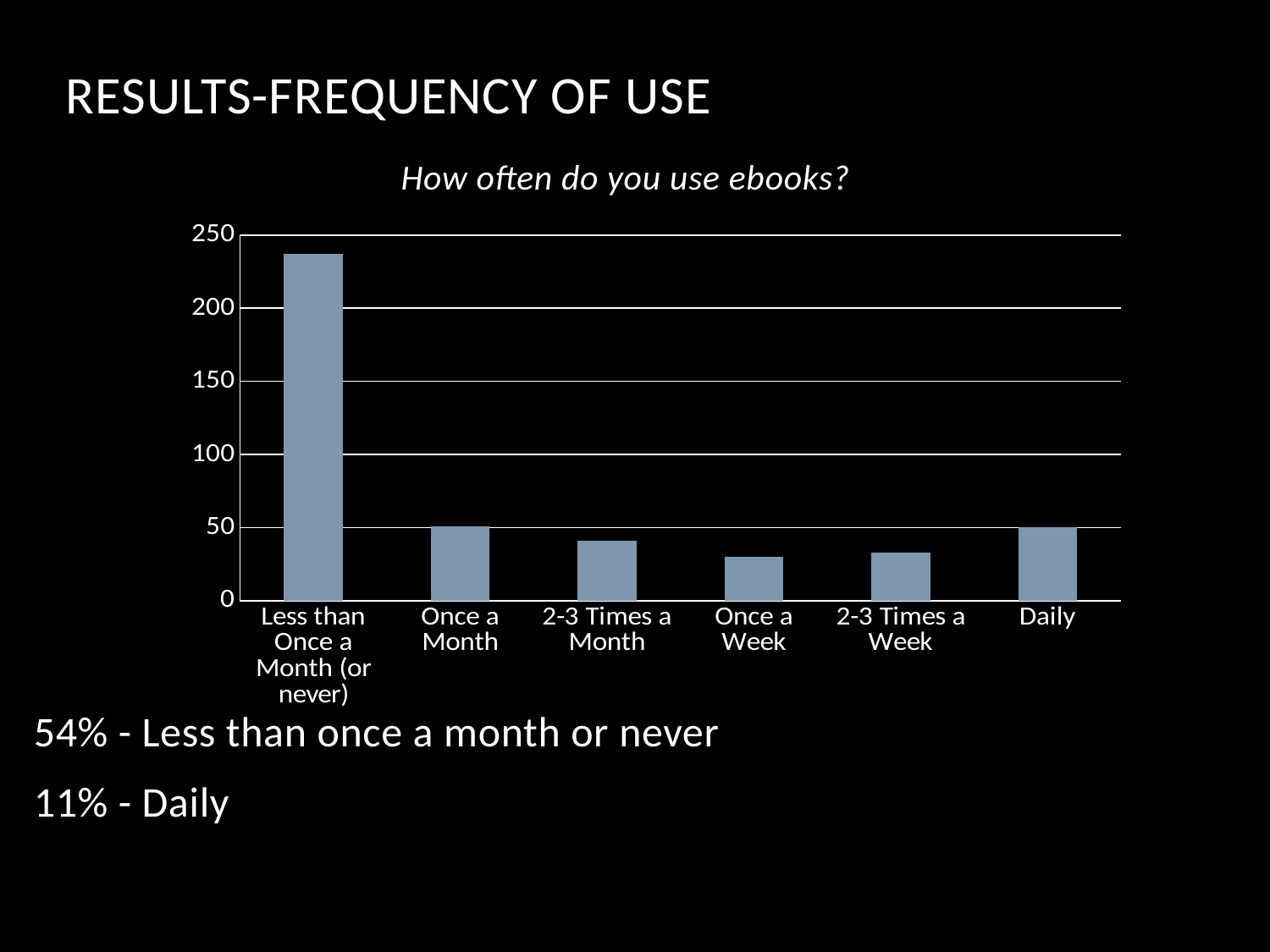
Which category has the highest value in the chart? Less than Once a Month (or never) Which is larger, the value for Less than Once a Month (or never) or the value for Daily? Less than Once a Month (or never) Is the value for 2-3 Times a Month greater or less than 50? less Which is larger, the value for Once a Month or the value for Once a Week? Once a Month What is the highest value shown on the y axis of the chart? 250 What kind of chart is shown on the slide? bar chart Is the value for Daily greater or less than 100? less Is the value for Less than Once a Month (or never) greater or less than 200? greater What is the title of the chart? How often do you use ebooks? How many categories are shown on the x axis of the chart? 6